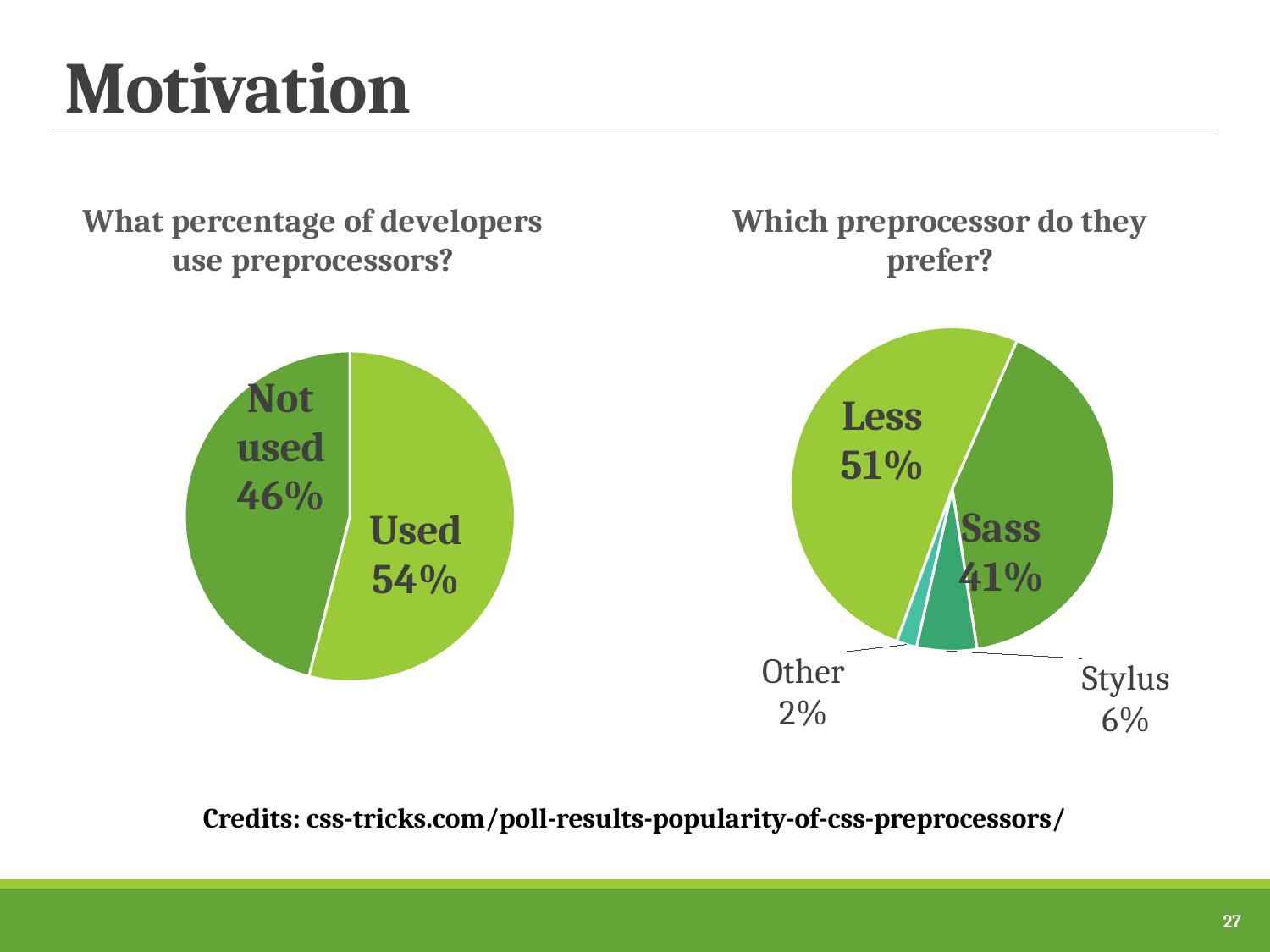
In the right chart titled "Which preprocessor do they prefer?", what is the share for "Stylus"? 6% In the right chart titled "Which preprocessor do they prefer?", how many categories are shown? 4 What type of chart is used for "Which preprocessor do they prefer?"? Pie chart In the left chart titled "What percentage of developers use preprocessors?", what is the share for "Not used"? 46% In the right chart titled "Which preprocessor do they prefer?", which category has the smallest share? Other In the left chart titled "What percentage of developers use preprocessors?", how many slices does the pie have? 2 In the left chart titled "What percentage of developers use preprocessors?", what is the difference between the "Used" and "Not used" shares? 8% In the left chart titled "What percentage of developers use preprocessors?", which slice is larger, "Used" or "Not used"? Used In the right chart titled "Which preprocessor do they prefer?", which preprocessor has the largest share? Less In the right chart titled "Which preprocessor do they prefer?", what is the share for "Sass"? 41% In the right chart titled "Which preprocessor do they prefer?", what is the difference between the "Less" and "Sass" shares? 10% In the left chart titled "What percentage of developers use preprocessors?", what is the share for "Used"? 54%